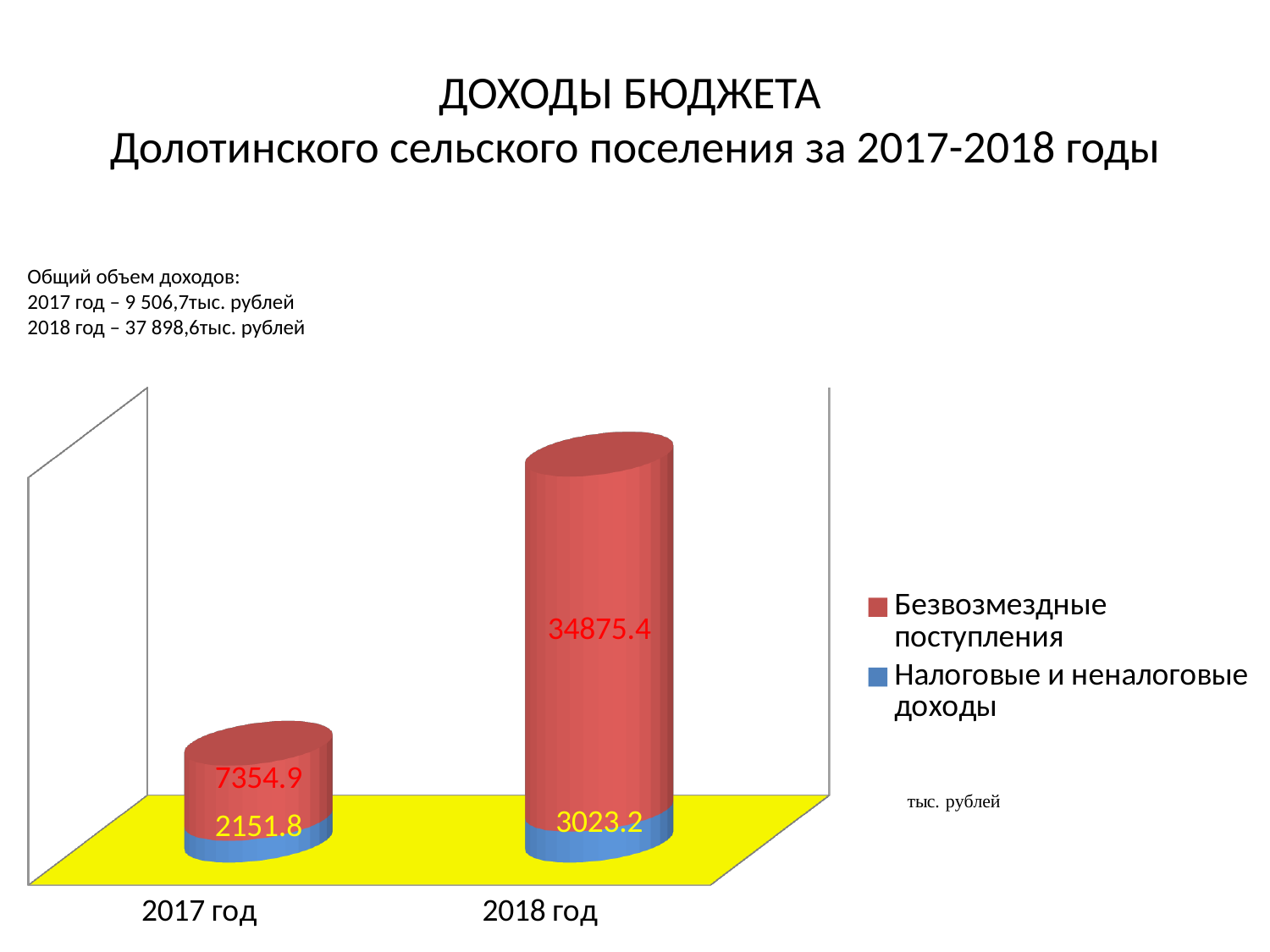
What is the value of Налоговые и неналоговые доходы for 2018 год? 3023.2 Which year has the lower value of Налоговые и неналоговые доходы? 2017 год By how much did Безвозмездные поступления increase from 2017 год to 2018 год? 27520.5 What is the value of Налоговые и неналоговые доходы for 2017 год? 2151.8 What is the value of Безвозмездные поступления for 2017 год? 7354.9 What is the value of Безвозмездные поступления for 2018 год? 34875.4 What is the difference between Налоговые и неналоговые доходы in 2018 год and 2017 год? 871.4 What kind of chart is shown on the slide? Stacked bar chart What is the total of the stacked bar for 2018 год? 37898.6 How many series does the legend list? 2 What is the total of the stacked bar for 2017 год? 9506.7 Which year has the higher value of Безвозмездные поступления? 2018 год